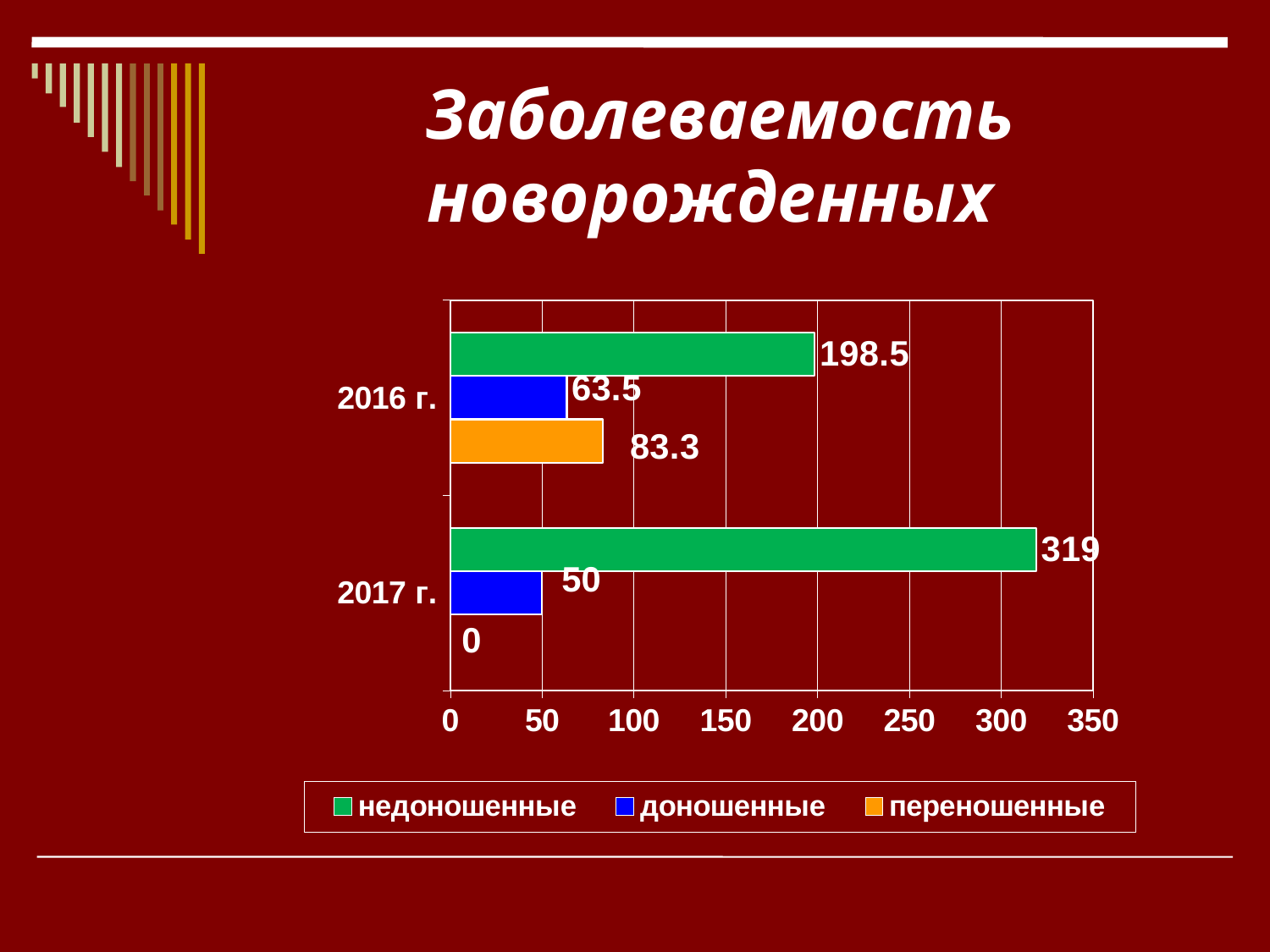
Which is larger: доношенные in 2016 г. or доношенные in 2017 г.? доношенные in 2016 г. What kind of chart is shown on the slide? bar chart What is the value for недоношенные in 2016 г.? 198.5 What is the value for доношенные in 2017 г.? 50 Is the value for недоношенные in 2017 г. greater or less than 300? greater What is the value for переношенные in 2017 г.? 0 What colour are the bars for доношенные? blue How many series does the legend list? 3 What is the difference between the недоношенные values for 2017 г. and 2016 г.? 120.5 Which series has the lowest value in 2016 г.? доношенные Which series has the highest value in 2017 г.? недоношенные What is the value for переношенные in 2016 г.? 83.3